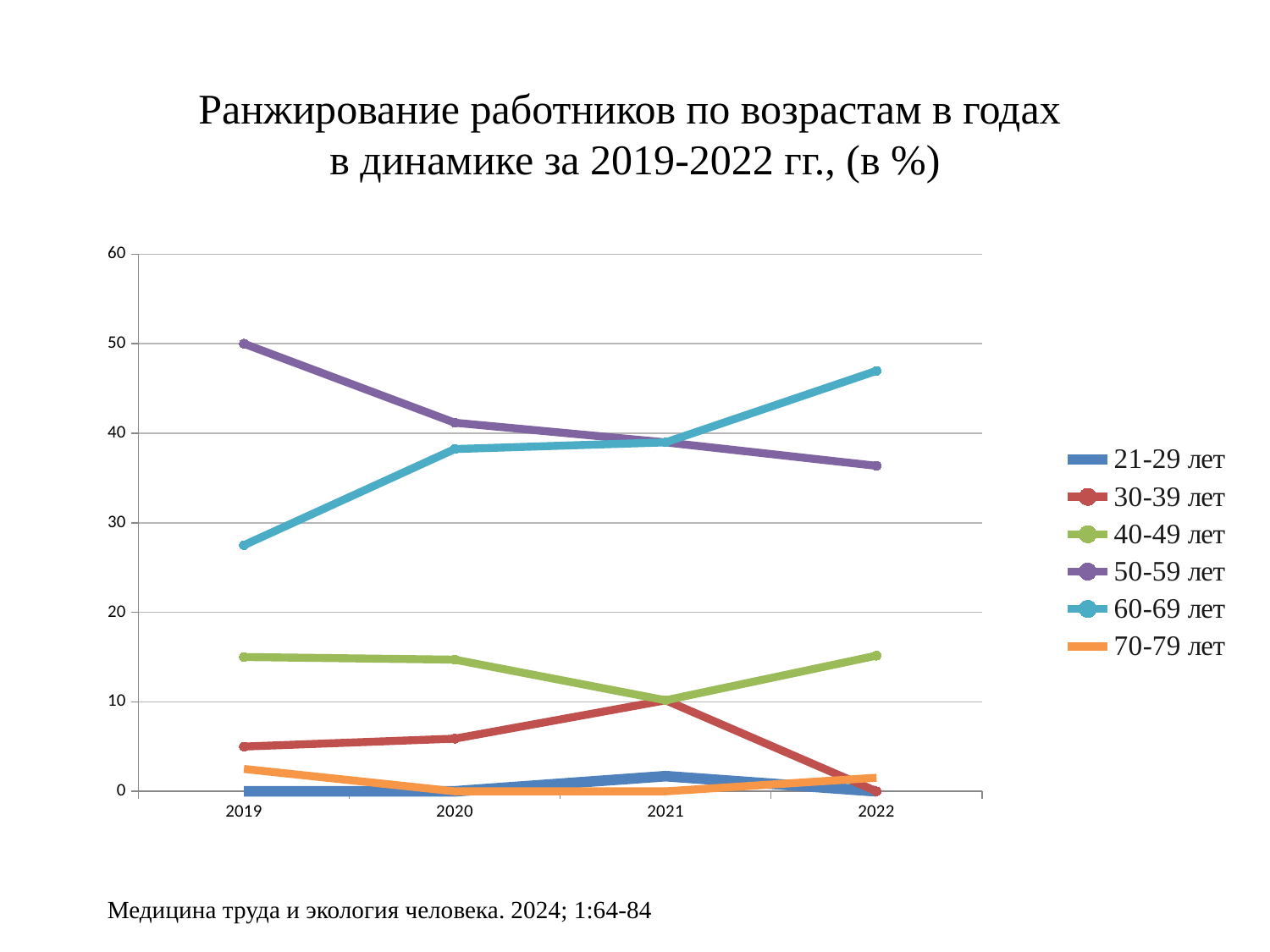
How many series does the legend list? 6 In 2022, which is larger: the value for 60-69 лет or for 50-59 лет? 60-69 лет Is the value for 50-59 лет in 2022 greater or less than 40? less What kind of chart is shown on the slide? line chart Does the line for 60-69 лет rise or fall from 2019 to 2022? rise Is the value for 60-69 лет in 2022 greater or less than 40? greater Which age group has the highest value in 2019? 50-59 лет In 2019, which is larger: the value for 50-59 лет or for 60-69 лет? 50-59 лет Is the value for 40-49 лет in 2021 greater or less than 20? less Does the line for 50-59 лет rise or fall from 2019 to 2022? fall How many years are shown along the x axis? 4 Which age group is listed first in the legend? 21-29 лет